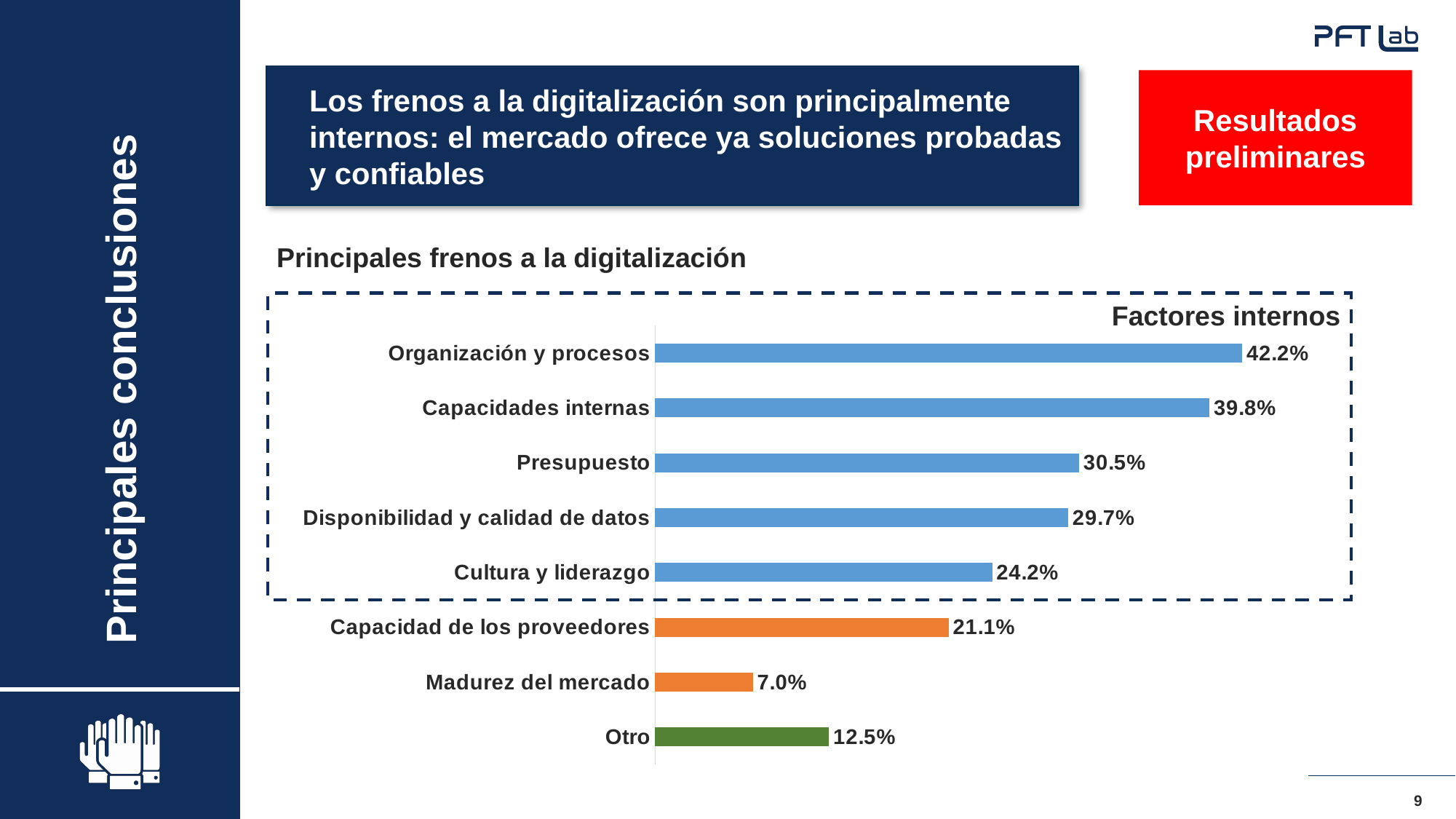
What is the title of the chart? Principales frenos a la digitalización What is the difference between Organización y procesos and Capacidades internas? 2.4% What is the value for Madurez del mercado? 7.0% What kind of chart is this? Bar chart Which category has the highest value? Organización y procesos What is the value for Otro? 12.5% Which is larger, Cultura y liderazgo or Capacidad de los proveedores? Cultura y liderazgo What is the difference between Capacidad de los proveedores and Madurez del mercado? 14.1% Which category has the lowest value? Madurez del mercado How many categories are shown in the chart? 8 What is the value for Presupuesto? 30.5% What is the value for Organización y procesos? 42.2%